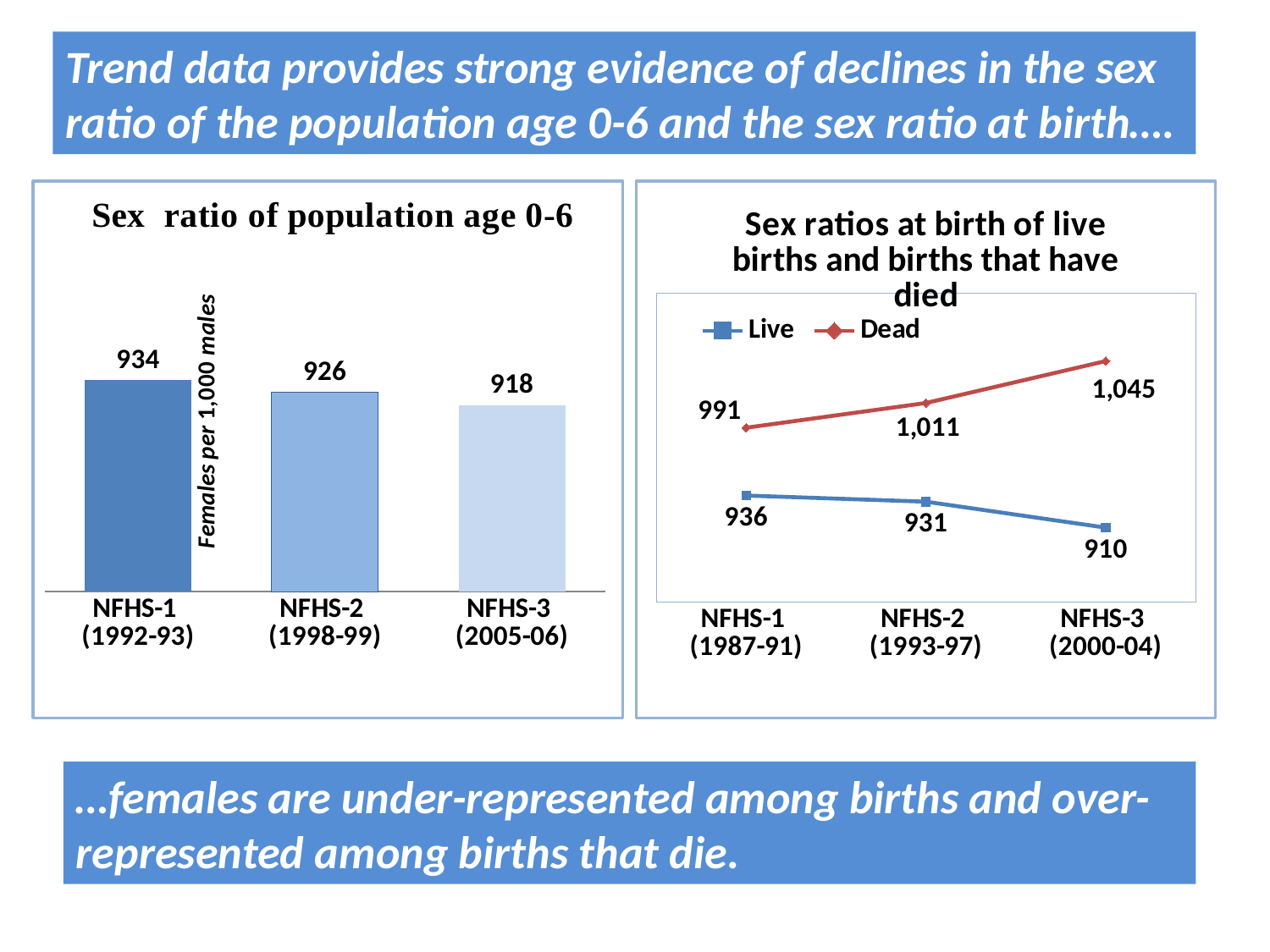
In the 'Sex ratios at birth of live births and births that have died' chart, how many series does the legend list? 2 In the 'Sex ratios at birth of live births and births that have died' chart, what is the Dead value for NFHS-3 (2000-04)? 1,045 In the 'Sex ratio of population age 0-6' chart, what kind of chart is shown? Bar chart In the 'Sex ratios at birth of live births and births that have died' chart, does the Dead series rise or fall from NFHS-1 to NFHS-3? Rise In the 'Sex ratio of population age 0-6' chart, what is the y-axis label? Females per 1,000 males In the 'Sex ratios at birth of live births and births that have died' chart, what is the Live value for NFHS-2 (1993-97)? 931 In the 'Sex ratio of population age 0-6' chart, what is the value for NFHS-2 (1998-99)? 926 In the 'Sex ratio of population age 0-6' chart, which survey has the lowest sex ratio? NFHS-3 (2005-06) In the 'Sex ratios at birth of live births and births that have died' chart, what is the difference between the Dead and Live values for NFHS-1 (1987-91)? 55 In the 'Sex ratio of population age 0-6' chart, do the values rise or fall from NFHS-1 to NFHS-3? Fall In the 'Sex ratio of population age 0-6' chart, which survey has the highest sex ratio? NFHS-1 (1992-93) In the 'Sex ratio of population age 0-6' chart, what is the difference between the NFHS-1 and NFHS-3 values? 16